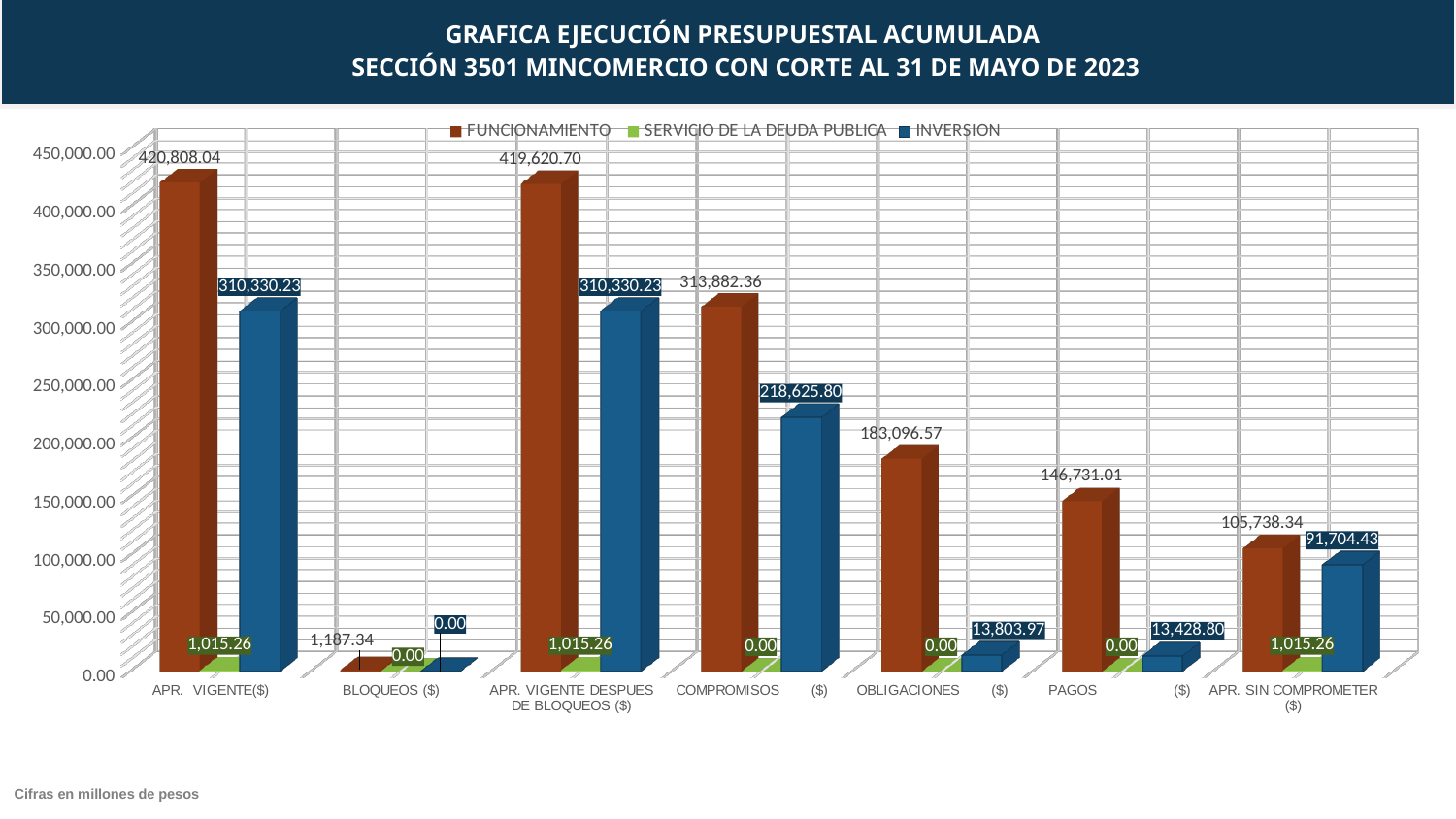
What is the INVERSION value for COMPROMISOS ($)? 218,625.80 How many categories are shown on the x axis? 7 What is the difference between the FUNCIONAMIENTO and INVERSION values for COMPROMISOS ($)? 95,256.56 What is the SERVICIO DE LA DEUDA PUBLICA value for APR. SIN COMPROMETER ($)? 1,015.26 Which category has the highest FUNCIONAMIENTO value? APR. VIGENTE($) What is the FUNCIONAMIENTO value for APR. VIGENTE($)? 420,808.04 What is the difference between the FUNCIONAMIENTO values for APR. VIGENTE($) and APR. VIGENTE DESPUES DE BLOQUEOS ($)? 1,187.34 Which is larger for OBLIGACIONES ($): the FUNCIONAMIENTO value or the INVERSION value? FUNCIONAMIENTO How many series does the legend list? 3 What is the INVERSION value for PAGOS ($)? 13,428.80 What kind of chart is shown on the slide? Bar chart Which category has the lowest FUNCIONAMIENTO value? BLOQUEOS ($)